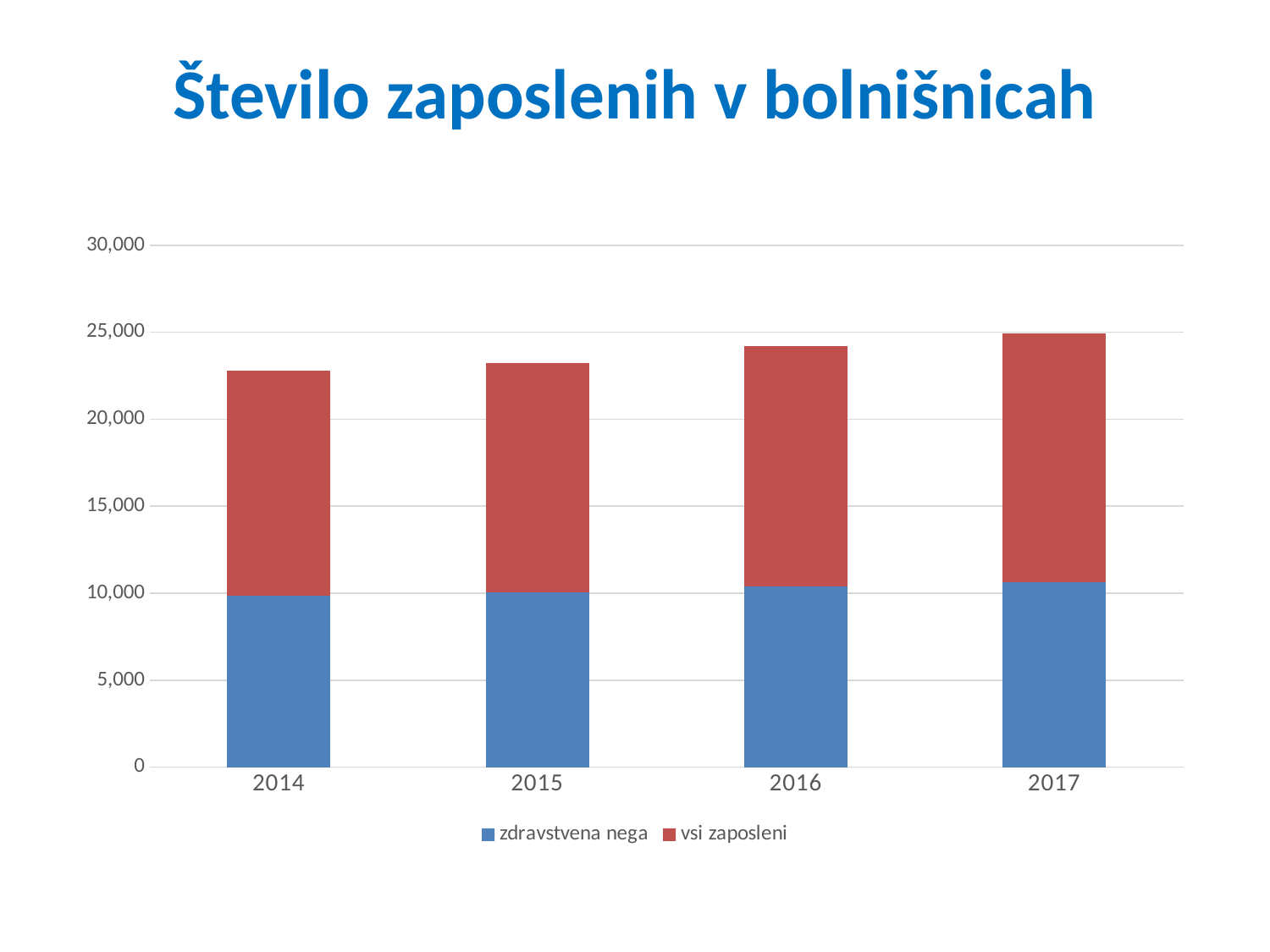
Is the value for zdravstvena nega in 2017 greater or less than 10,000? greater Is the total stacked bar for 2016 greater or less than 25,000? less How many series does the legend list? 2 Do the stacked bar totals rise or fall from 2014 to 2017? rise Which colour represents the series vsi zaposleni in the chart? red What is the title of the chart? Število zaposlenih v bolnišnicah Which is larger, the total stacked bar for 2017 or for 2014? 2017 Which year has the shortest stacked bar? 2014 What kind of chart is shown on the slide? bar chart Is the total stacked bar for 2014 greater or less than 20,000? greater How many years are shown on the x axis of the chart? 4 Which year has the tallest stacked bar? 2017